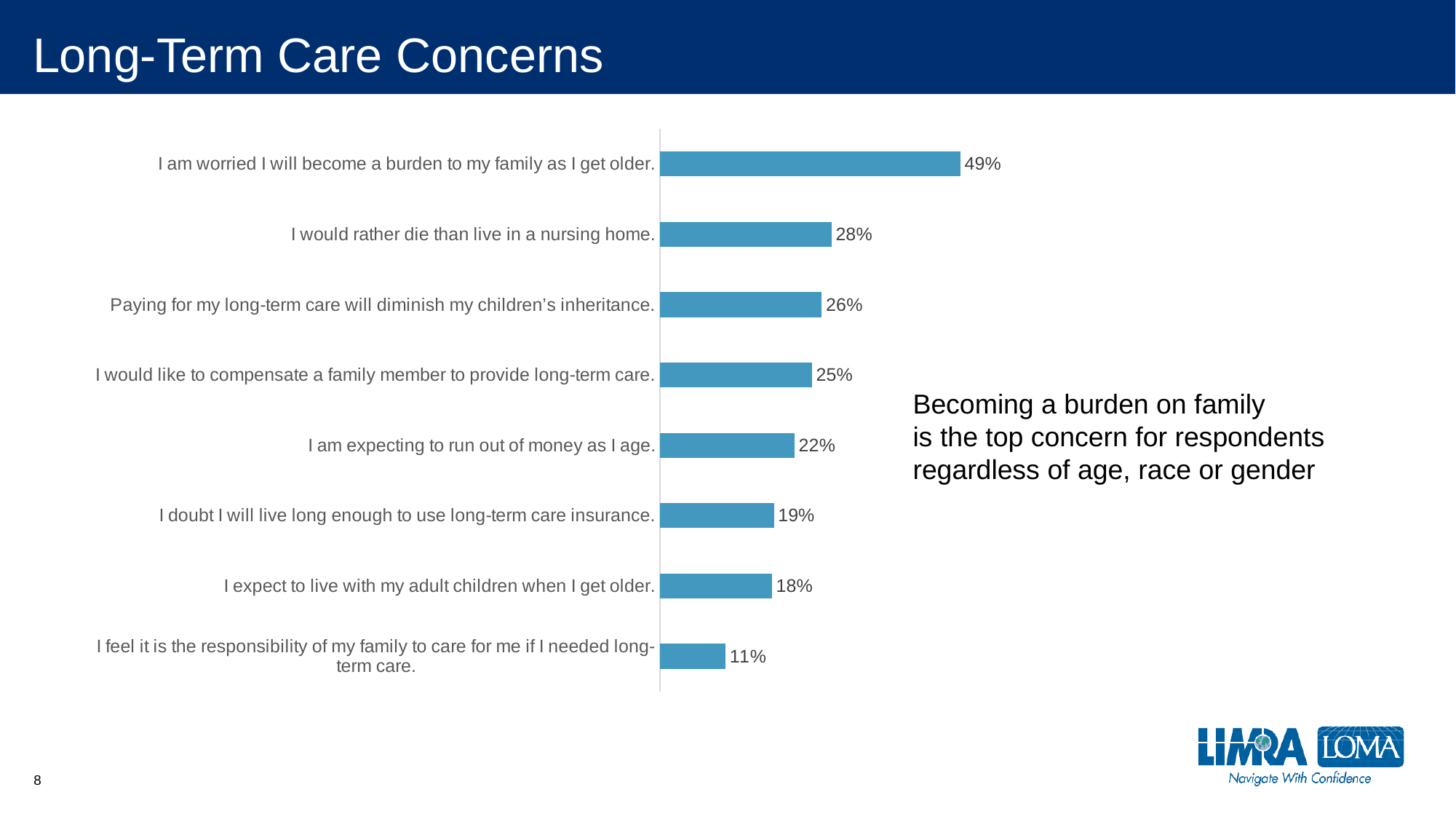
What is the difference between "I doubt I will live long enough to use long-term care insurance." and "I expect to live with my adult children when I get older."? 1 percentage point What percentage of respondents expect to run out of money as they age? 22% What is the value for "I feel it is the responsibility of my family to care for me if I needed long-term care."? 11% What type of chart is shown on the slide? Bar chart What is the difference in percentage points between "I am worried I will become a burden to my family as I get older." and "I would rather die than live in a nursing home."? 21 percentage points How many statements are shown in the chart? 8 What is the title of the slide containing the chart? Long-Term Care Concerns Which statement has the lowest percentage? I feel it is the responsibility of my family to care for me if I needed long-term care. What percentage of respondents said they are worried they will become a burden to their family as they get older? 49% Which concern has the highest percentage? I am worried I will become a burden to my family as I get older. What is the value for "I would rather die than live in a nursing home."? 28% Which is larger: the value for "Paying for my long-term care will diminish my children's inheritance." or the value for "I am expecting to run out of money as I age."? Paying for my long-term care will diminish my children's inheritance.